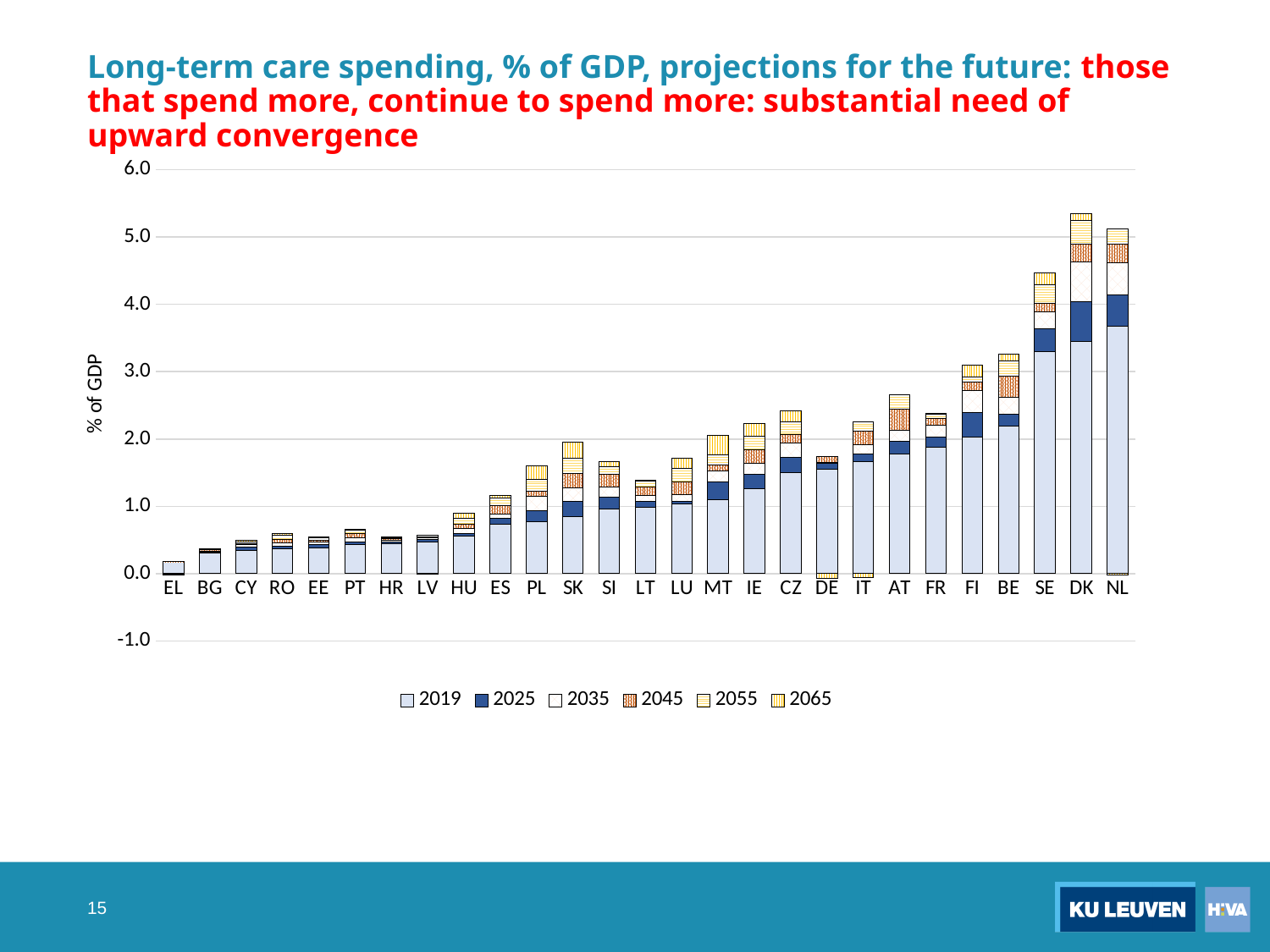
How many series does the legend list? 6 What is the label on the y axis? % of GDP How many countries are shown along the x axis? 27 Do the stacked bar totals generally rise or fall from left to right along the x axis? Rise Which country has the shortest stacked bar? EL Is the total stacked value for DE greater or less than 2.0? less Is the total stacked value for SE greater or less than 4.0? greater What kind of chart is shown on the slide? Stacked bar chart Is the total stacked value for HU greater or less than 1.0? less Which has the taller stacked bar, SE or DK? DK Which country has the tallest stacked bar? DK